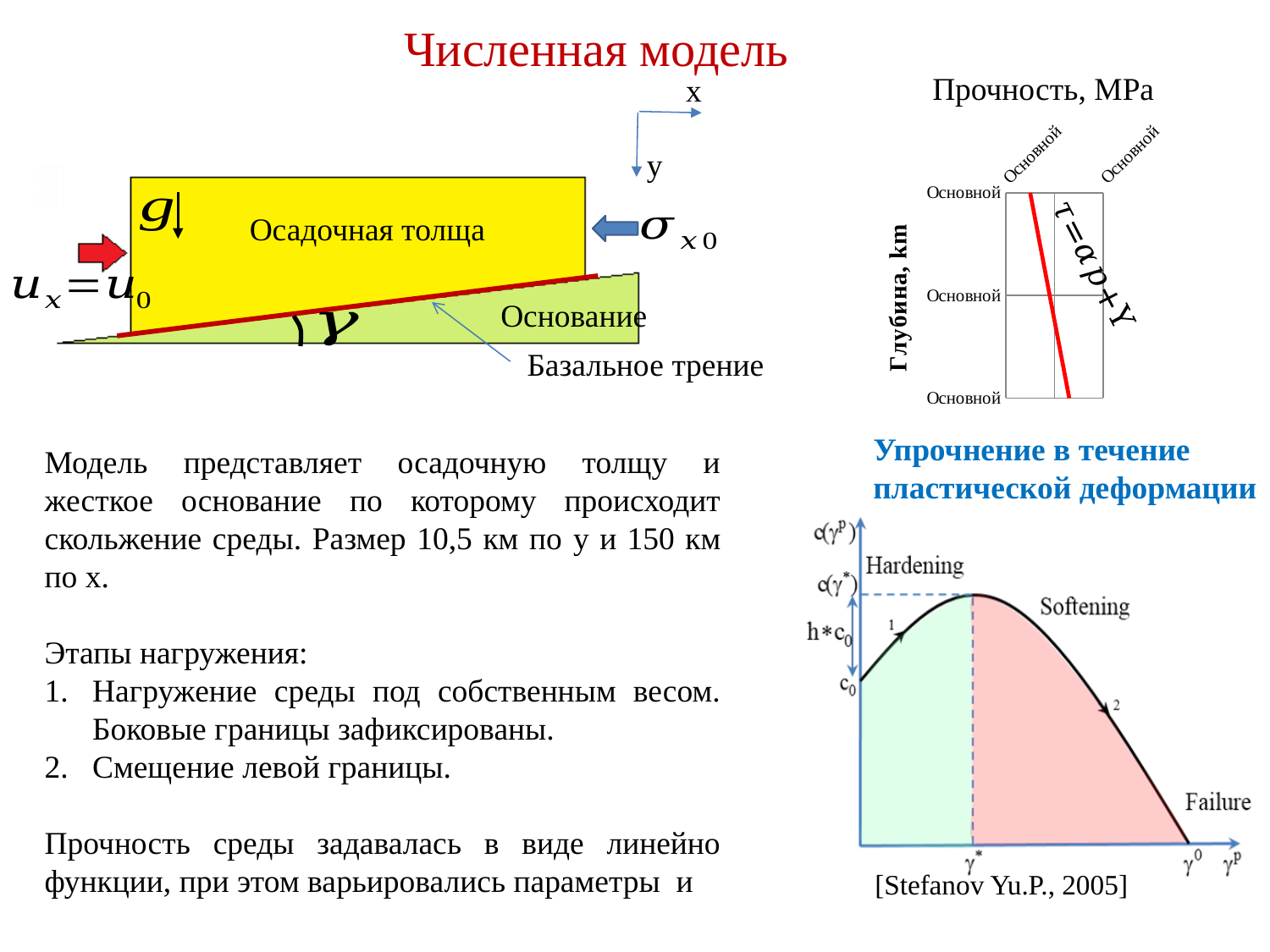
In the hardening/softening chart at the bottom right, what is the maximum value of the curve labelled on the vertical axis? c(γ*) In the hardening/softening chart at the bottom right, does the curve rise or fall between γ* and γ0? falls In the hardening/softening chart at the bottom right, at which value of γ^p does the curve reach its maximum? γ* In the hardening/softening chart at the bottom right, what is the value of the curve at γ^p = 0? c0 How many shaded regions are there under the curve in the hardening/softening chart at the bottom right? 2 What kind of chart is the chart titled 'Прочность, MPa' in the upper right of the slide? line chart In the hardening/softening chart at the bottom right, does the curve rise or fall between γ^p = 0 and γ*? rises What is the vertical axis label of the chart titled 'Прочность, MPa'? Глубина, km In the chart titled 'Прочность, MPa', does the red line move to the right or to the left as depth increases down the vertical axis? to the right What equation is written next to the red line in the chart titled 'Прочность, MPa'? τ=αp+Y